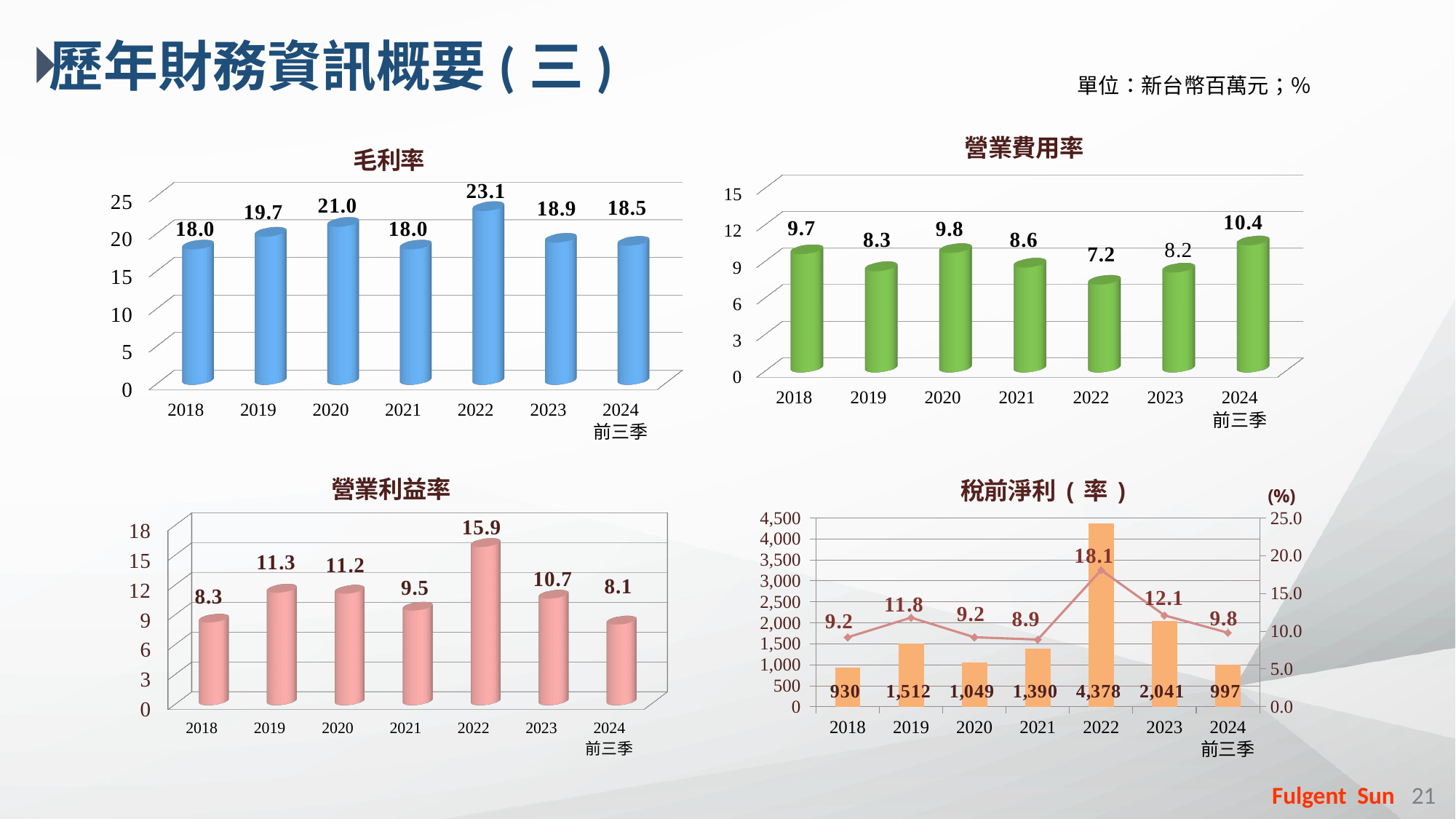
In the 營業利益率 chart, what is the value for 2019? 11.3 In the 稅前淨利（率） chart, what is the bar value for 2022? 4,378 In the 毛利率 chart, what is the value for 2022? 23.1 In the 稅前淨利（率） chart, what is the difference between the bar values for 2023 and 2024前三季? 1,044 In the 毛利率 chart, which year has the highest value? 2022 In the 營業費用率 chart, what is the value for 2022? 7.2 In the 營業費用率 chart, what is the difference between the 2024前三季 value and the 2023 value? 2.2 What kind of chart is the 毛利率 chart? Bar chart In the 營業利益率 chart, how many categories are shown on the x axis? 7 In the 營業費用率 chart, which category has the lowest value? 2022 In the 營業利益率 chart, which is larger, the value for 2021 or the value for 2023? 2023 In the 稅前淨利（率） chart, what is the line value for 2019? 11.8